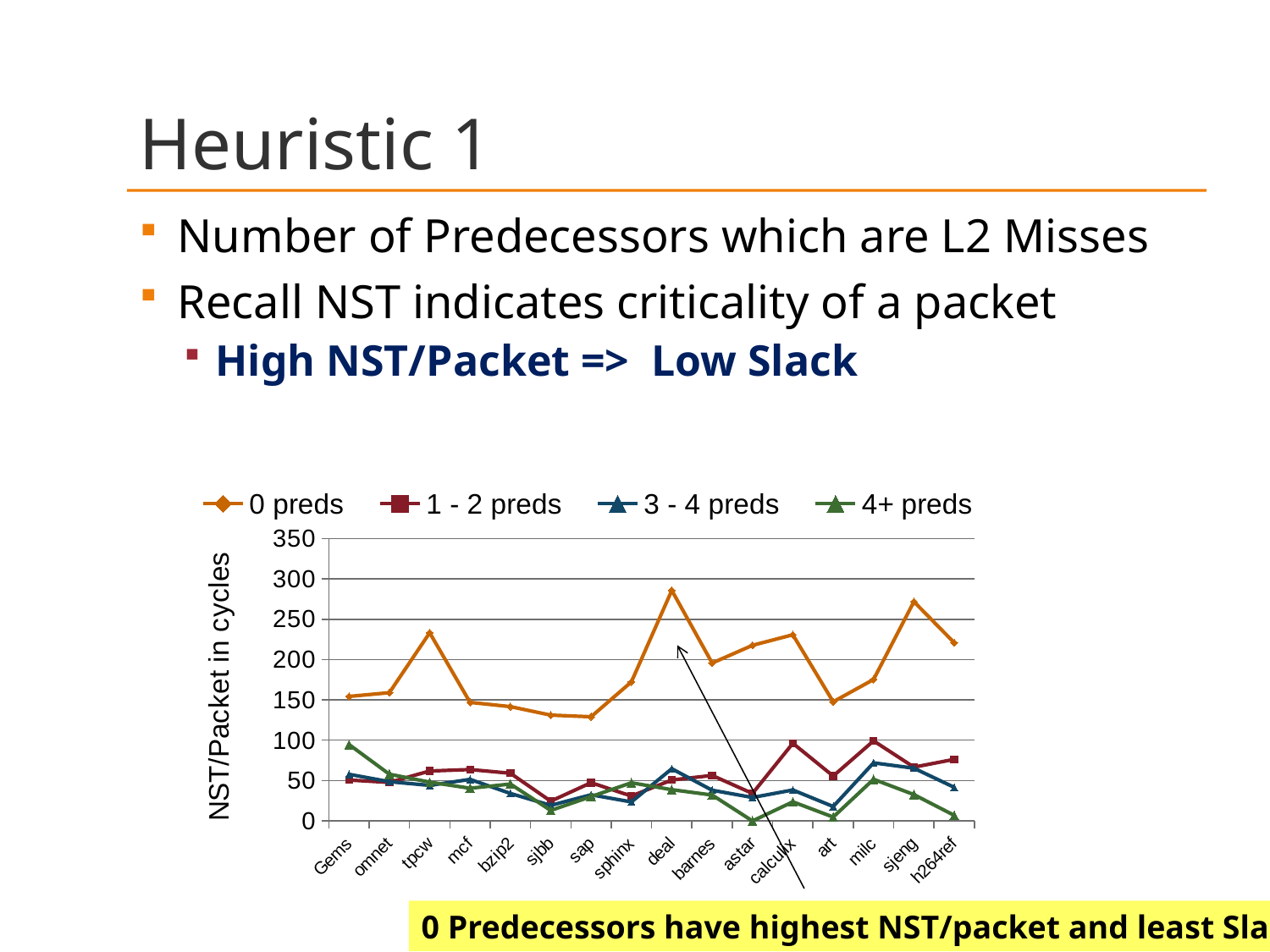
At deal, which is larger: the value for 0 preds or the value for 3 - 4 preds? 0 preds Is the value for 1 - 2 preds at calculix greater or less than 50? greater How many series does the chart's legend list? 4 At Gems, which is larger: the value for 4+ preds or the value for 1 - 2 preds? 4+ preds Is the value for 0 preds at tpcw greater or less than 200? greater Is the value for 0 preds at Gems greater or less than 200? less What kind of chart is shown on the slide? line chart What is the title of the chart's y axis? NST/Packet in cycles How many benchmark categories are plotted along the x axis? 16 Which series has the highest NST/Packet values across all benchmarks? 0 preds